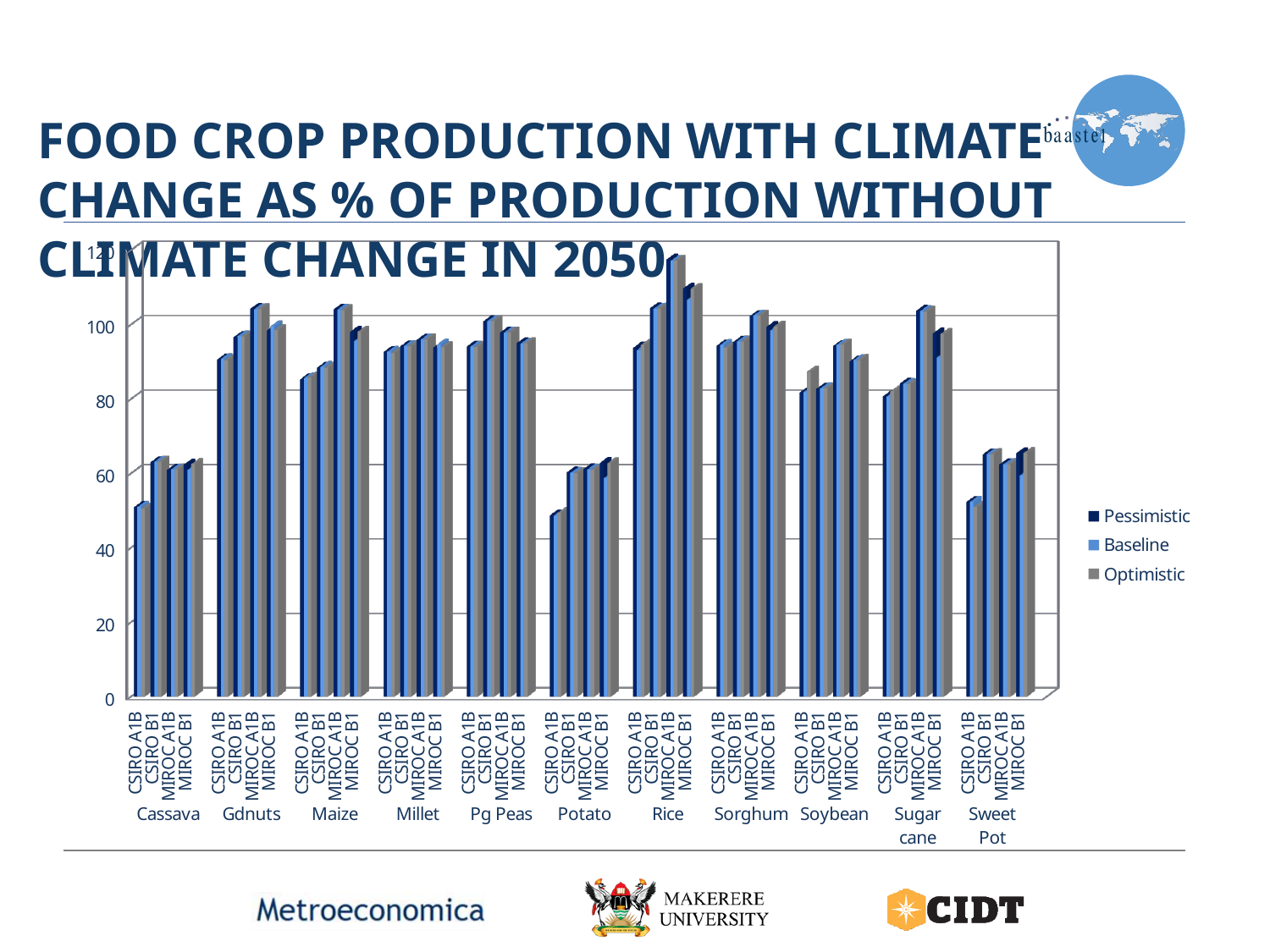
Is the Baseline value for Gdnuts under MIROC A1B greater or less than 100? greater What are the three series named in the legend? Pessimistic, Baseline, Optimistic Is the Baseline value for Rice under MIROC A1B greater or less than 100? greater How many series does the legend list? 3 Which crop has the highest bar on the chart? Rice What kind of chart is shown on the slide? bar chart Is the Baseline value for Millet under CSIRO A1B greater or less than 100? less How many crop groups are shown along the x axis? 11 Which is larger, the Baseline value for Rice under CSIRO A1B or the Baseline value for Potato under CSIRO A1B? Rice under CSIRO A1B How many climate scenarios (e.g. CSIRO A1B) are shown within each crop group? 4